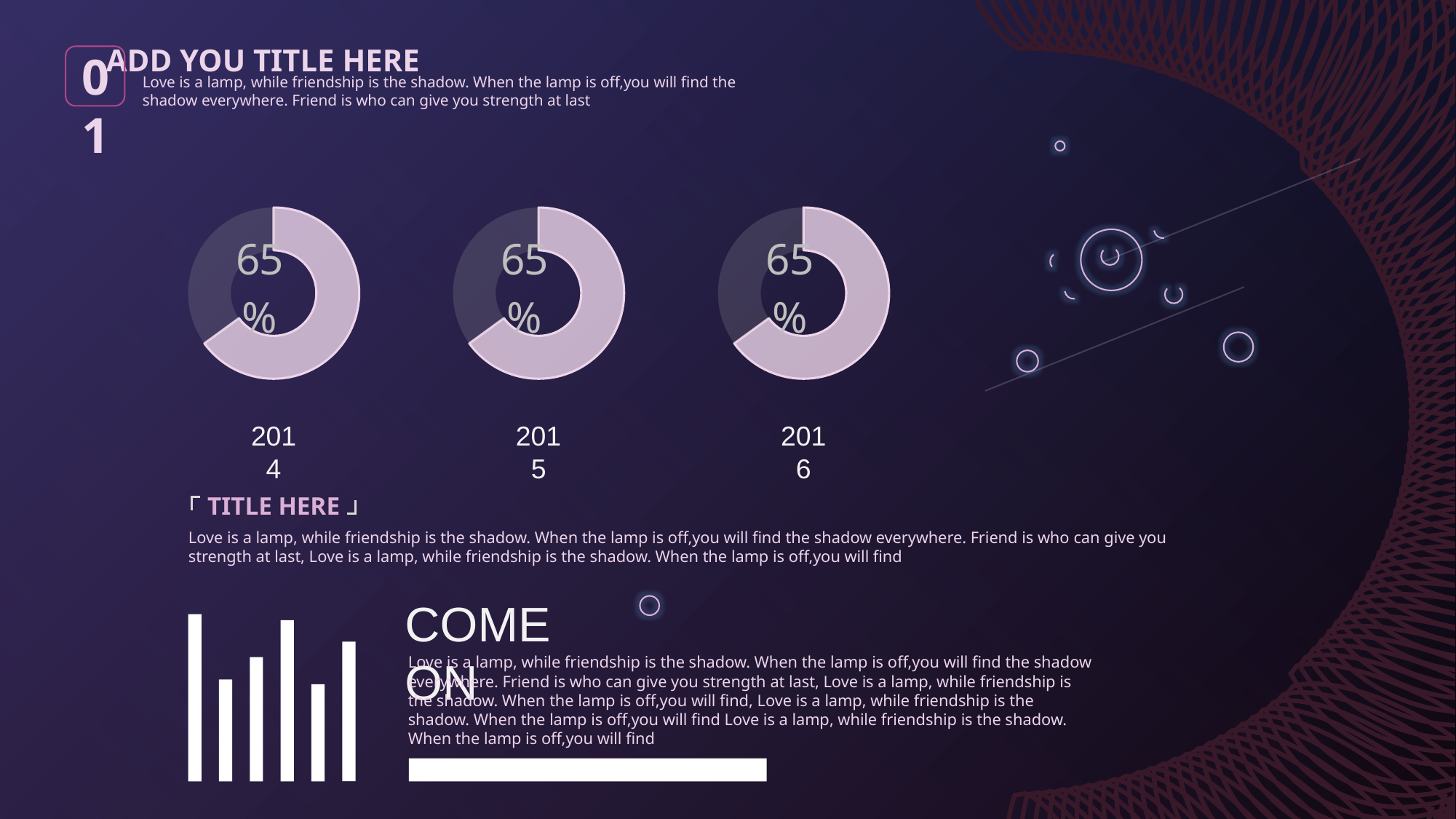
What percentage is shown in the donut chart labelled 2015? 65% What percentage is shown in the donut chart labelled 2016? 65% Is the value shown in the 2016 donut chart greater or less than 70%? less What is the difference between the percentage shown for 2014 and the percentage shown for 2016? 0% What share of the 2014 donut chart is filled by the highlighted segment? 65% Do the percentages shown in the donut charts rise, fall or stay the same from 2014 to 2016? Stay the same What kind of chart is used to show the 2014, 2015 and 2016 values? Donut chart How many donut charts are shown on the slide? 3 Which years are labelled under the three donut charts? 2014, 2015, 2016 What percentage is shown in the donut chart labelled 2014? 65% Is the value shown in the 2015 donut chart greater or less than 50%? greater